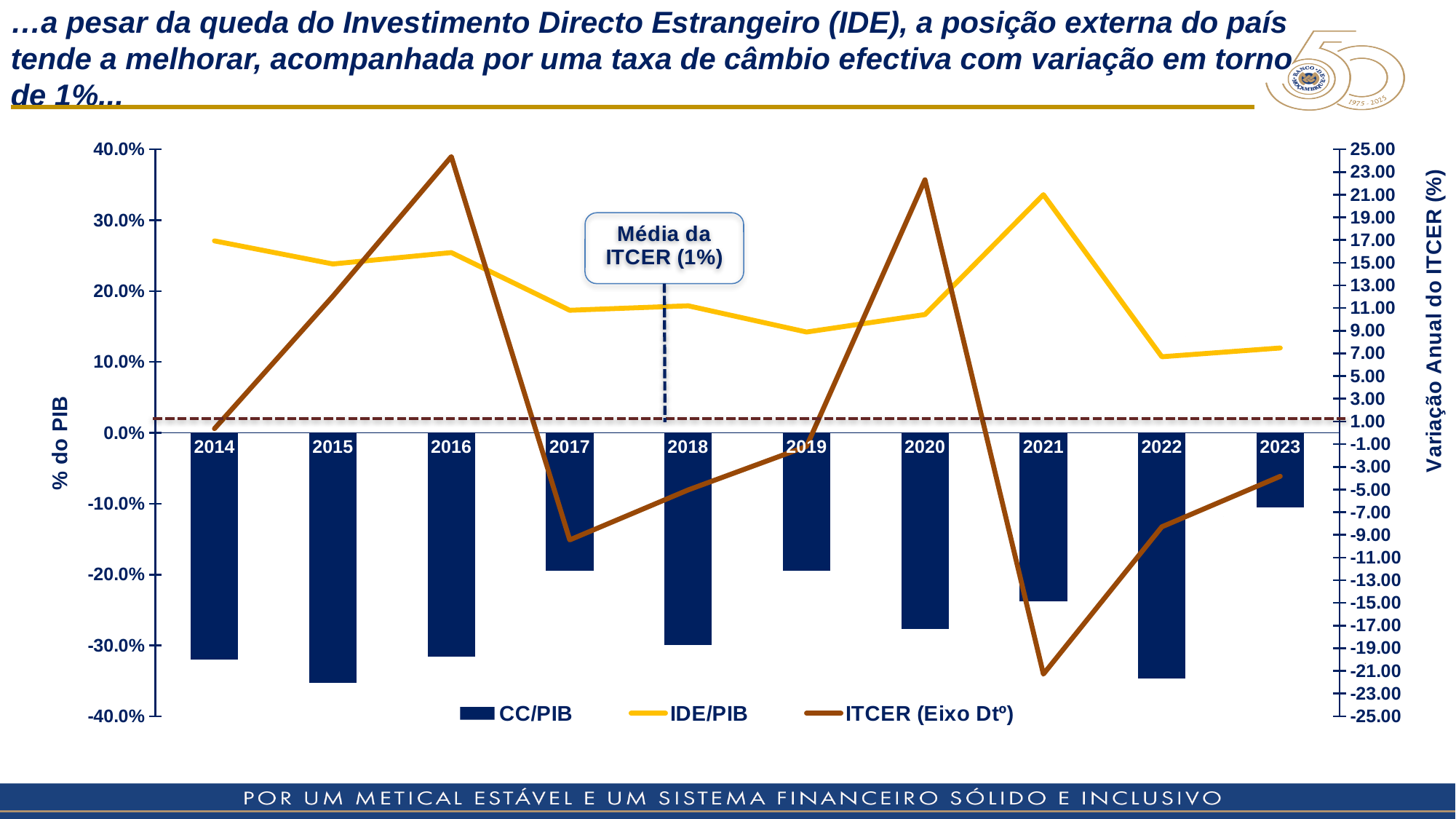
Is the CC/PIB value for 2015 greater or less than -30.0%? less Is the IDE/PIB value for 2021 greater or less than 30.0%? greater Which year has the lowest ITCER value? 2021 How many years are shown on the x axis? 10 Which year has the highest IDE/PIB value? 2021 Is the ITCER value for 2021 greater or less than -20.00? less How many series does the legend list? 3 What kind of chart is shown on the slide? Combined bar and line chart Which is larger, the IDE/PIB value for 2014 or for 2017? 2014 Which year has the highest ITCER value? 2016 What value does the dashed horizontal line represent, according to its label? Média da ITCER (1%) Which year has the highest (least negative) CC/PIB value? 2023